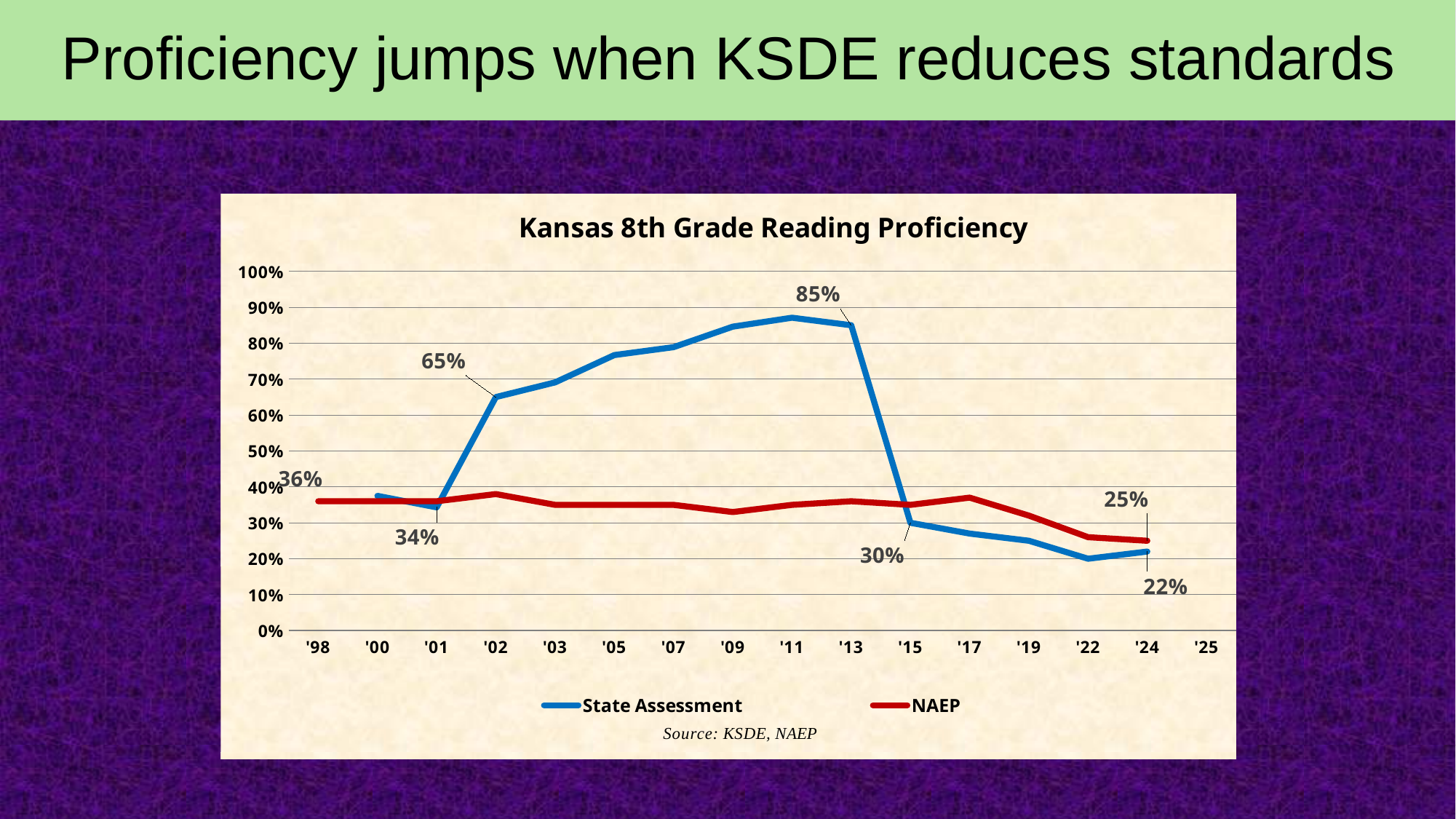
What is the State Assessment value in '13? 85% What is the title of the chart? Kansas 8th Grade Reading Proficiency Is the State Assessment value in '11 greater or less than 80%? greater How many series does the legend list? 2 What is the State Assessment value in '02? 65% What is the State Assessment value in '24? 22% Does the State Assessment line rise or fall between '13 and '15? fall What is the NAEP value in '98? 36% Which is larger in '24, the NAEP value or the State Assessment value? NAEP What is the NAEP value in '24? 25% What type of chart is shown on the slide? line chart What is the difference between the State Assessment values in '13 and '15? 55 percentage points